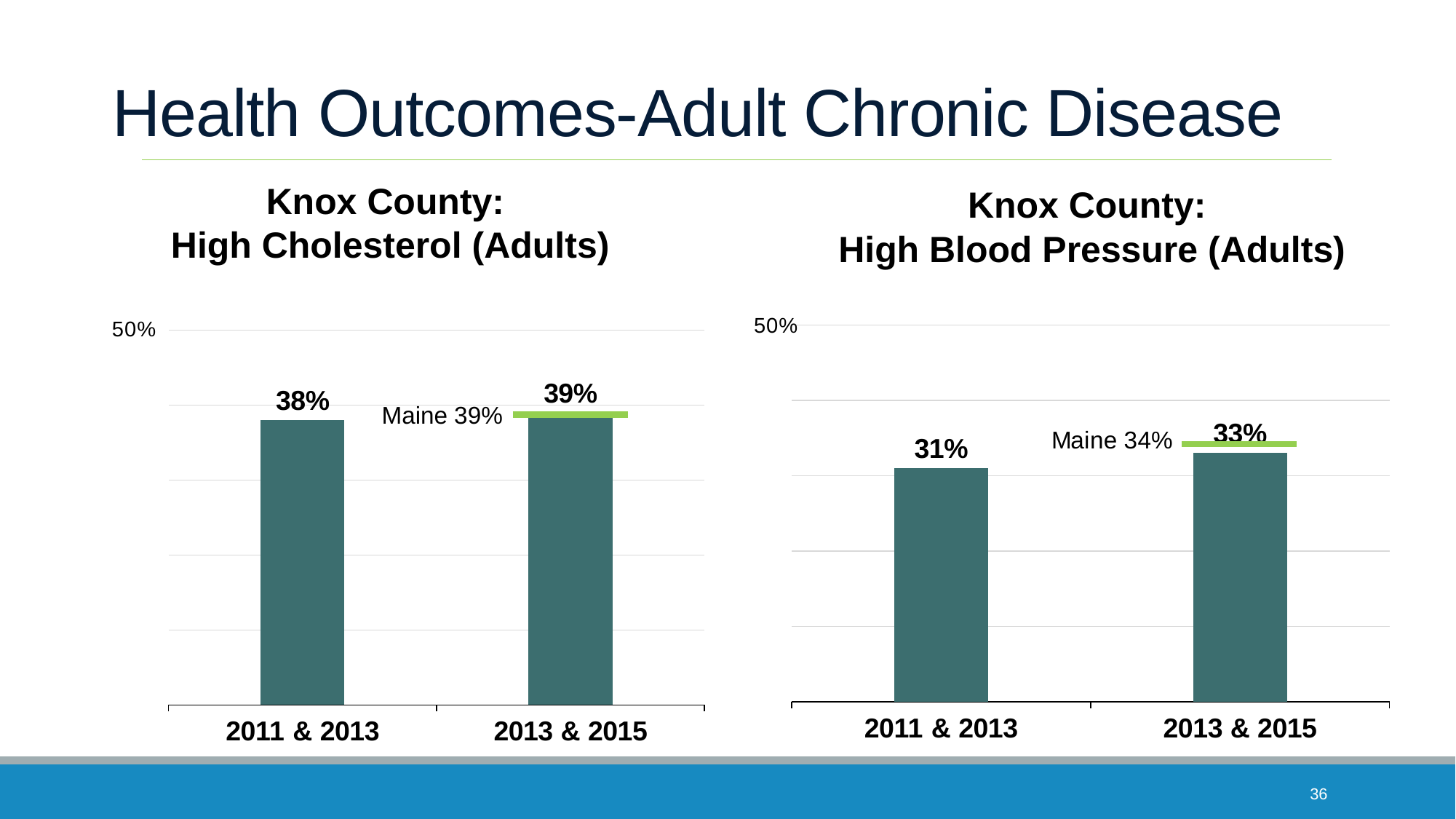
In the High Blood Pressure (Adults) chart, what is the Maine value shown by the green line? 34% In the High Blood Pressure (Adults) chart, what is the difference between the 2013 & 2015 value and the 2011 & 2013 value? 2% In the High Blood Pressure (Adults) chart, what is the value for 2011 & 2013? 31% In the High Cholesterol (Adults) chart, what is the value for 2013 & 2015? 39% In the High Blood Pressure (Adults) chart, what is the value for 2013 & 2015? 33% In the High Blood Pressure (Adults) chart, which period has the higher value, 2011 & 2013 or 2013 & 2015? 2013 & 2015 In the High Cholesterol (Adults) chart, what is the difference between the 2013 & 2015 value and the 2011 & 2013 value? 1% In the High Blood Pressure (Adults) chart, is the value for 2011 & 2013 greater or less than 50%? less How many bars are plotted in the High Cholesterol (Adults) chart? 2 In the High Cholesterol (Adults) chart, what is the Maine value shown by the green line? 39% What kind of chart is the High Blood Pressure (Adults) chart? bar chart In the High Cholesterol (Adults) chart, what is the value for 2011 & 2013? 38%